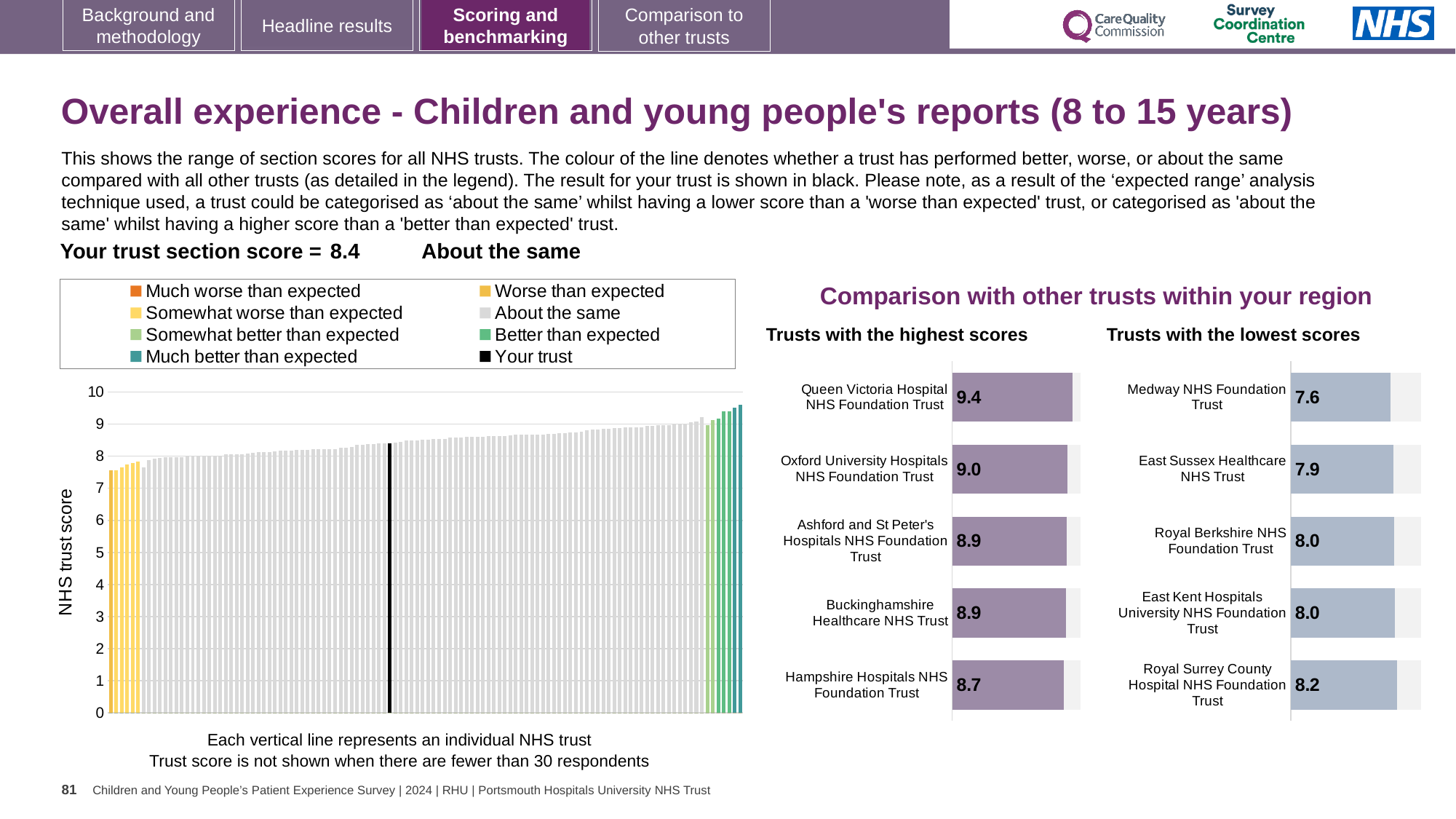
How many entries does the legend of the large chart on the left list? 8 In the 'Trusts with the highest scores' chart, what is the score for Hampshire Hospitals NHS Foundation Trust? 8.7 In the large chart on the left, what is the score for 'Your trust' (the black line)? 8.4 In the 'Trusts with the lowest scores' chart, which trust has the lowest score? Medway NHS Foundation Trust In the 'Trusts with the lowest scores' chart, which trust has the highest score? Royal Surrey County Hospital NHS Foundation Trust In the large chart on the left, do the trust scores rise or fall from left to right? rise In the 'Trusts with the highest scores' chart, what is the difference between the scores of Queen Victoria Hospital NHS Foundation Trust and Hampshire Hospitals NHS Foundation Trust? 0.7 In the 'Trusts with the lowest scores' chart, what is the score for Medway NHS Foundation Trust? 7.6 In the 'Trusts with the lowest scores' chart, which has the larger score: East Sussex Healthcare NHS Trust or Royal Surrey County Hospital NHS Foundation Trust? Royal Surrey County Hospital NHS Foundation Trust In the large chart on the left, is the score of the lowest-scoring trust greater or less than 8? less How many trusts are shown in the 'Trusts with the highest scores' chart? 5 In the 'Trusts with the highest scores' chart, what is the score for Queen Victoria Hospital NHS Foundation Trust? 9.4